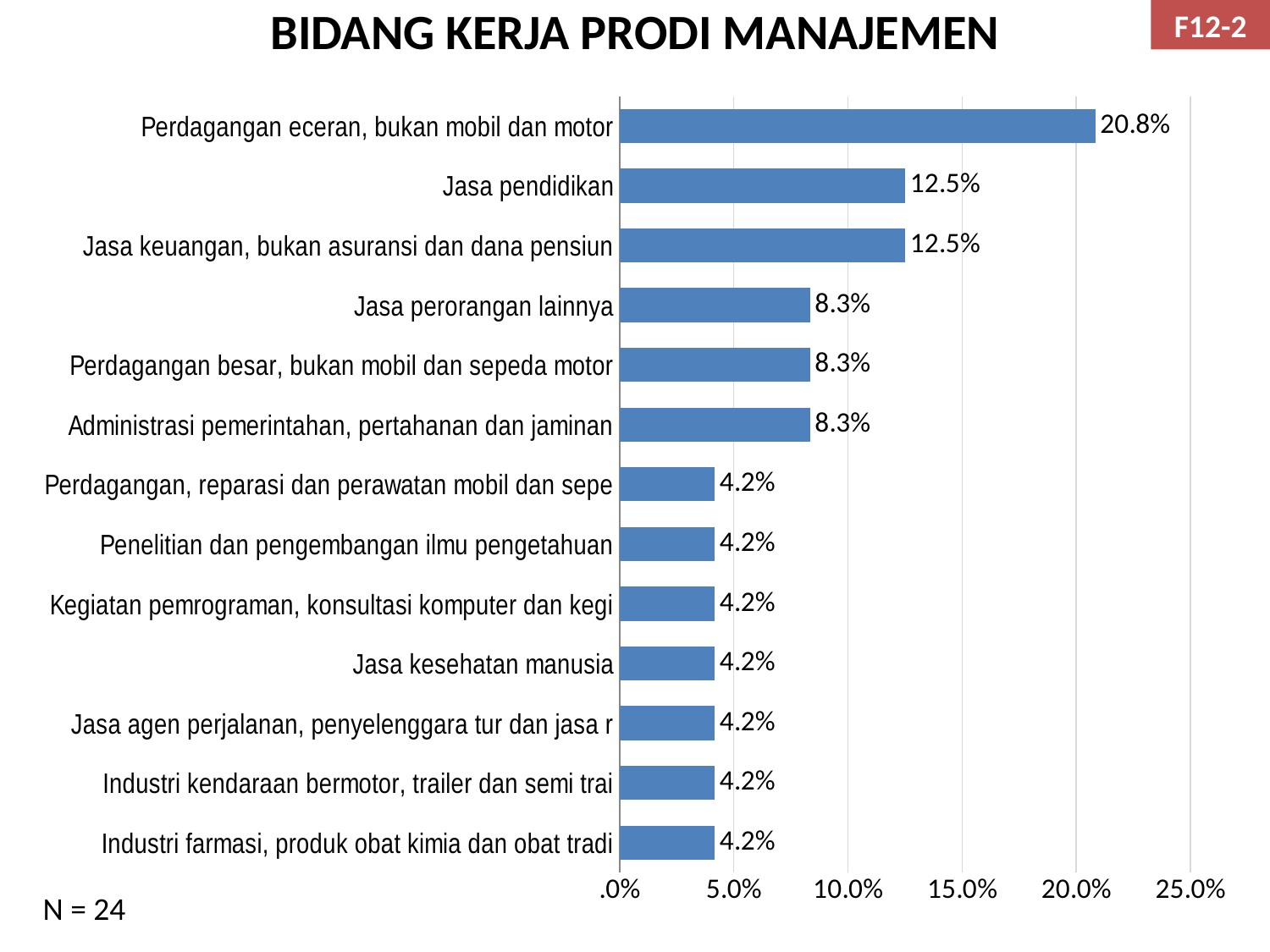
What kind of chart is shown on the slide? bar chart What is the value for Perdagangan eceran, bukan mobil dan motor? 20.8% How many categories are shown in the chart? 13 What is the value for Jasa pendidikan? 12.5% Which category has the highest value? Perdagangan eceran, bukan mobil dan motor What is the title of the chart? BIDANG KERJA PRODI MANAJEMEN Is the value for Perdagangan eceran, bukan mobil dan motor greater or less than 20.0%? greater Which is larger, the value for Jasa keuangan, bukan asuransi dan dana pensiun or the value for Administrasi pemerintahan, pertahanan dan jaminan? Jasa keuangan, bukan asuransi dan dana pensiun What is the difference between the values for Perdagangan eceran, bukan mobil dan motor and Jasa pendidikan? 8.3% What is the value for Jasa kesehatan manusia? 4.2% What is the difference between the values for Jasa perorangan lainnya and Jasa kesehatan manusia? 4.1% What is the value for Jasa perorangan lainnya? 8.3%